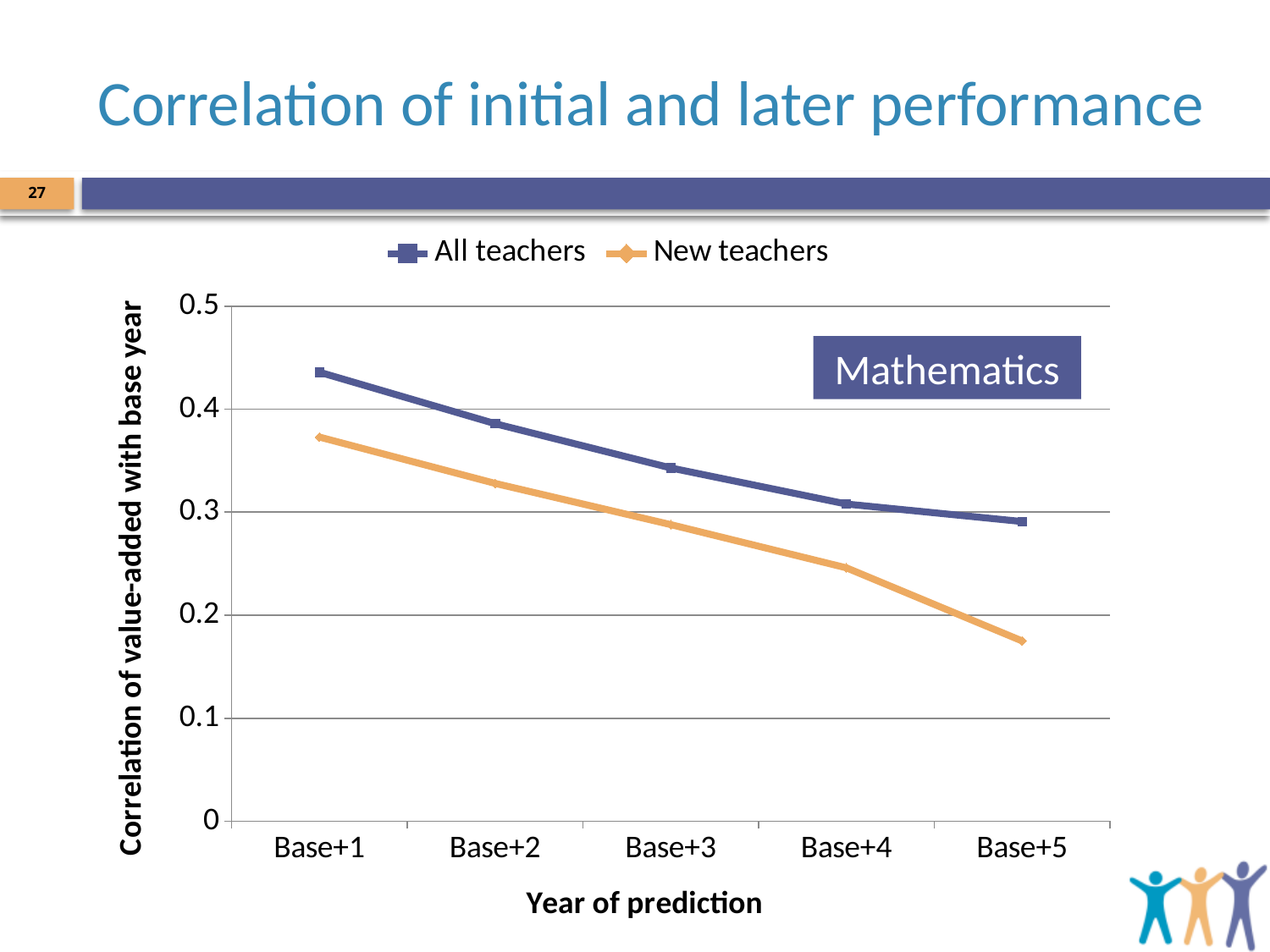
Is the value for New teachers at Base+4 greater or less than 0.3? less Do the values for New teachers rise or fall from Base+1 to Base+5? fall Do the values for All teachers rise or fall from Base+1 to Base+5? fall How many years of prediction are plotted along the x axis? 5 Is the value for New teachers at Base+5 greater or less than 0.2? less At which year of prediction is the correlation for All teachers highest? Base+1 What kind of chart is shown on the slide? line chart At Base+5, which series has the larger correlation, All teachers or New teachers? All teachers How many series does the legend list? 2 At which year of prediction is the correlation for New teachers lowest? Base+5 Is the value for All teachers at Base+1 greater or less than 0.4? greater Which subject is named in the label box inside the chart? Mathematics